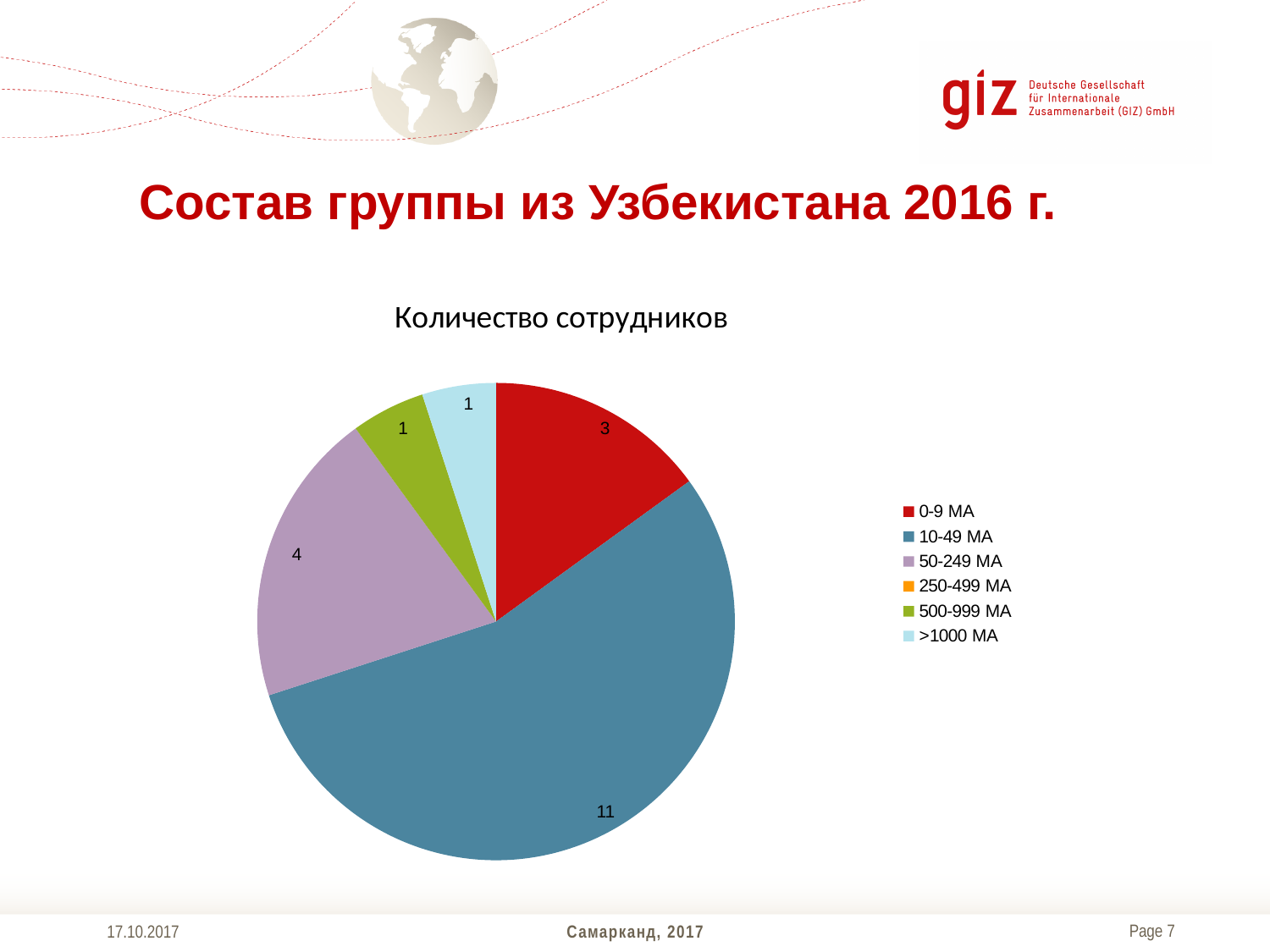
What is the value for the >1000 MA slice? 1 What is the difference between the values for 10-49 MA and 50-249 MA? 7 What is the value for the 0-9 MA slice? 3 What colour is the 10-49 MA slice? blue Which category has the largest slice? 10-49 MA Which is larger, the value for 0-9 MA or the value for 50-249 MA? 50-249 MA What is the value for the 50-249 MA slice? 4 What is the value for the 10-49 MA slice? 11 What type of chart is shown on the slide? pie chart How many categories does the legend list? 6 What is the title of the chart? Количество сотрудников What is the value for the 500-999 MA slice? 1